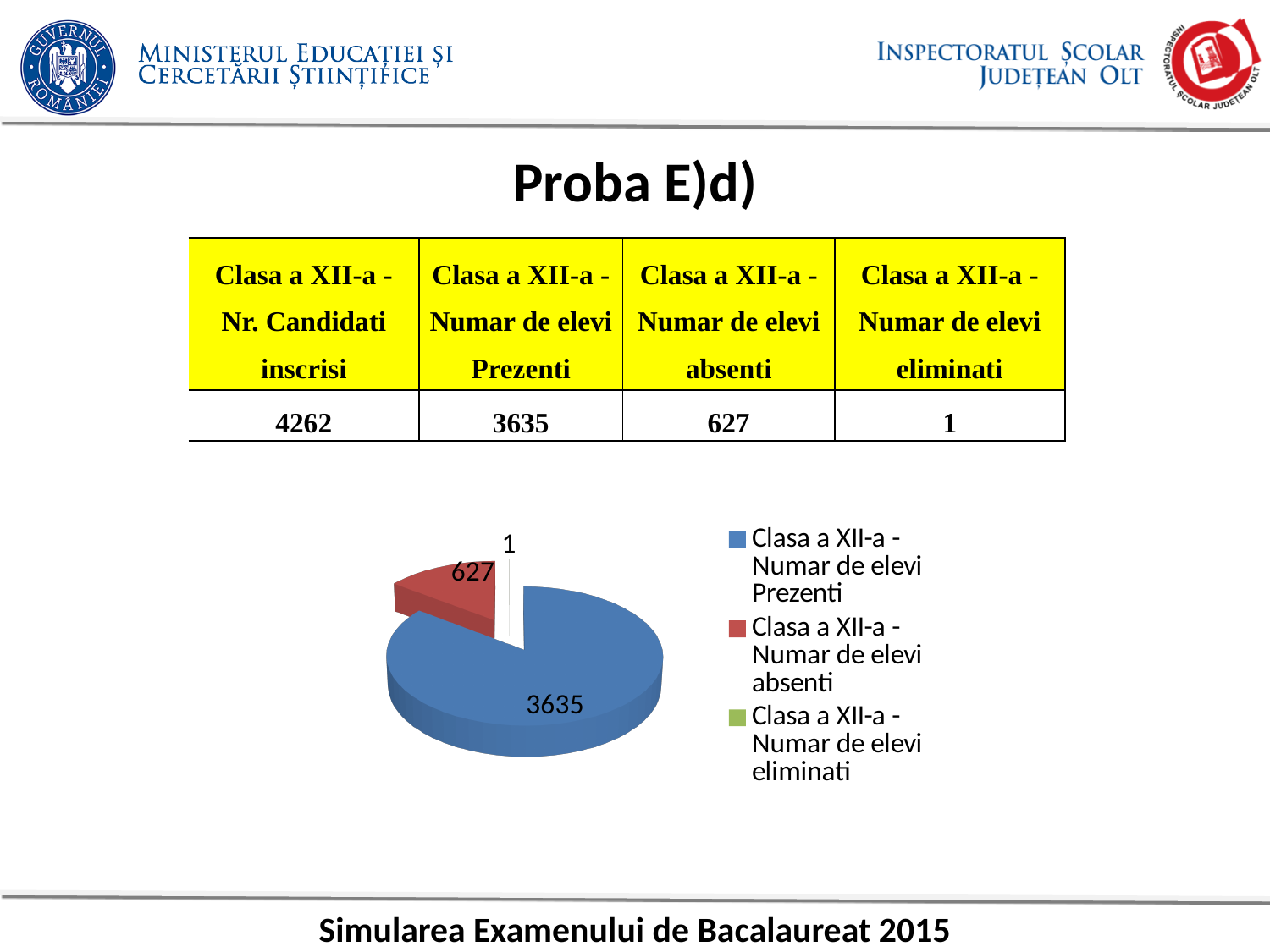
What colour is the slice for 'Clasa a XII-a - Numar de elevi absenti' in the pie chart? red What kind of chart is shown on the slide? pie chart What is the value of the slice for 'Clasa a XII-a - Numar de elevi eliminati'? 1 What is the total of all the slices in the pie chart? 4263 What is the value of the slice for 'Clasa a XII-a - Numar de elevi absenti'? 627 Which category has the smallest slice in the pie chart? Clasa a XII-a - Numar de elevi eliminati What is the value of the slice for 'Clasa a XII-a - Numar de elevi Prezenti'? 3635 What is the difference between the number of students present (Prezenti) and the number absent (absenti) in the pie chart? 3008 Which is larger in the pie chart: the slice for students absent (absenti) or the slice for students eliminated (eliminati)? Clasa a XII-a - Numar de elevi absenti How many slices does the pie chart have? 3 How many entries does the legend of the pie chart list? 3 Which category has the largest slice in the pie chart? Clasa a XII-a - Numar de elevi Prezenti